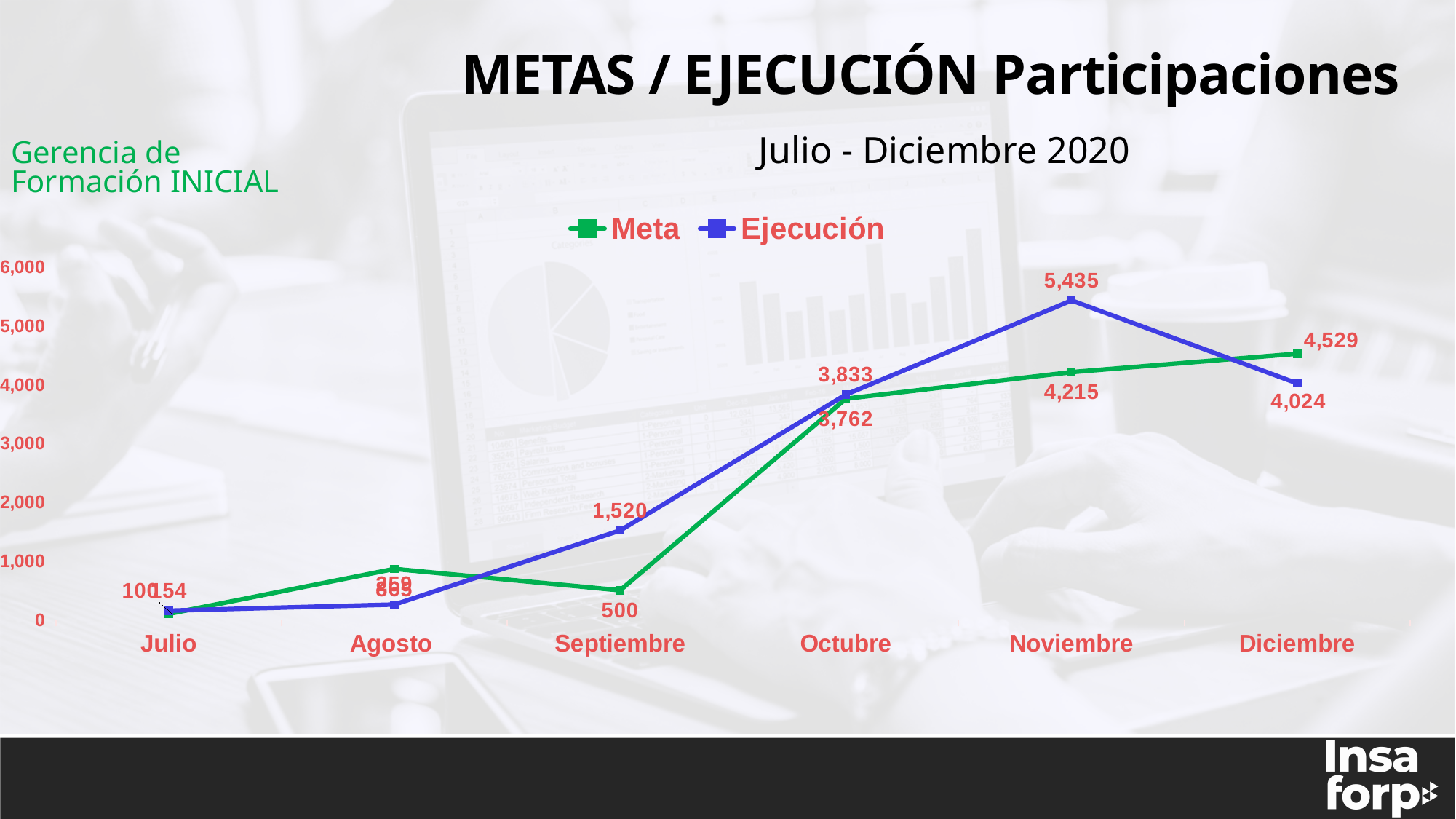
Is the Meta value for Agosto greater or less than 1,000? less What is the Ejecución value for Septiembre? 1,520 How many months are plotted along the x axis? 6 How many series does the legend list? 2 In which month is the Meta value lowest? Julio In which month is the Ejecución value highest? Noviembre What kind of chart is shown on the slide? line chart What is the difference between Ejecución and Meta in Noviembre? 1,220 What is the Meta value for Diciembre? 4,529 In Diciembre, which is larger, Meta or Ejecución? Meta Does the Ejecución line rise or fall from Noviembre to Diciembre? fall What is the Ejecución value for Noviembre? 5,435